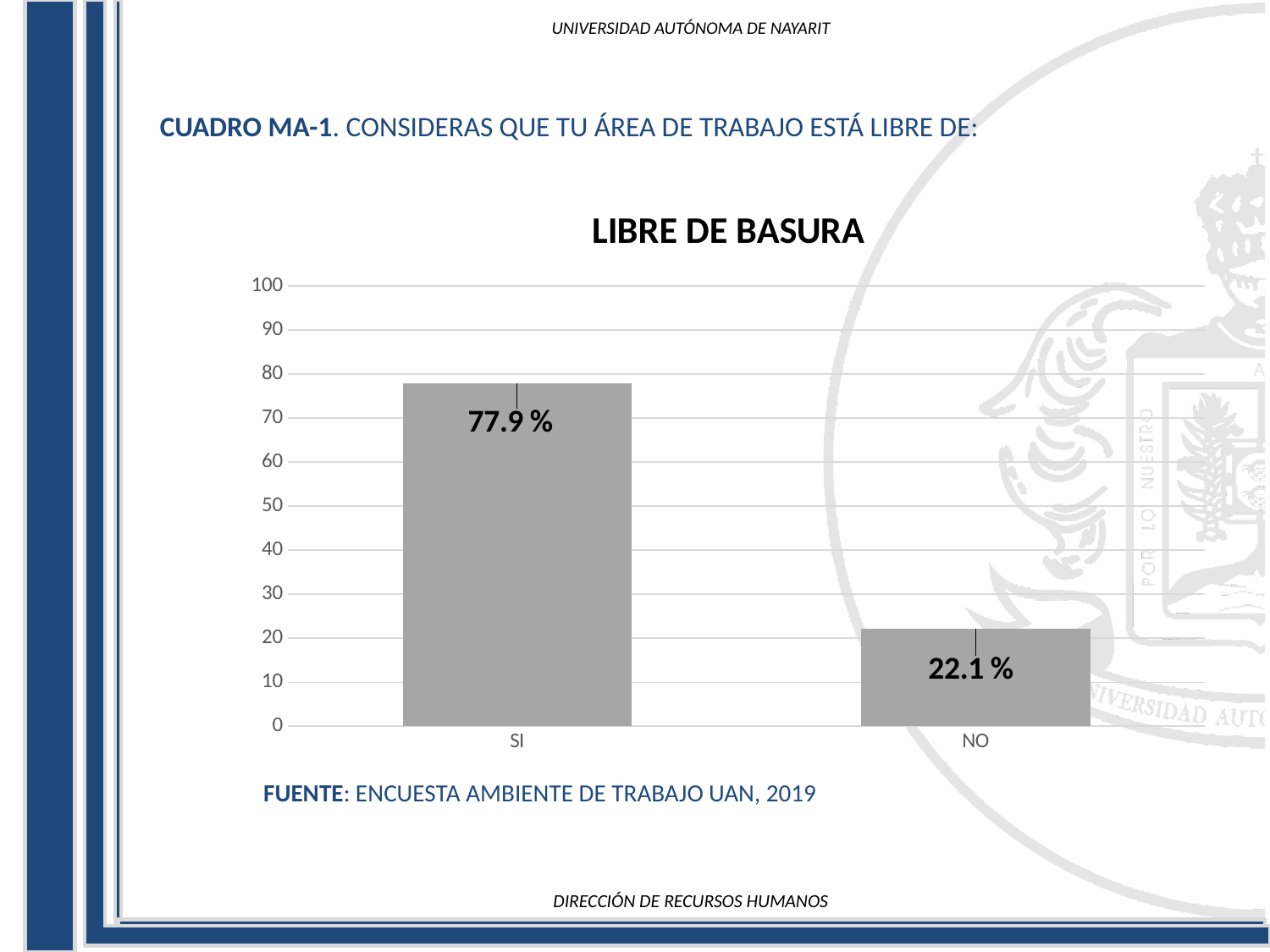
Is the value for NO greater or less than 30? less What is the difference between the values for SI and NO? 55.8 % Is the value for SI greater or less than 70? greater What is the value for SI? 77.9 % Which category has the highest value? SI Which category has the lowest value? NO How many categories are shown on the x axis? 2 What kind of chart is shown? bar chart What is the highest value shown on the y axis? 100 What is the title of the chart? LIBRE DE BASURA What is the value for NO? 22.1 % Which is larger, the value for SI or the value for NO? SI